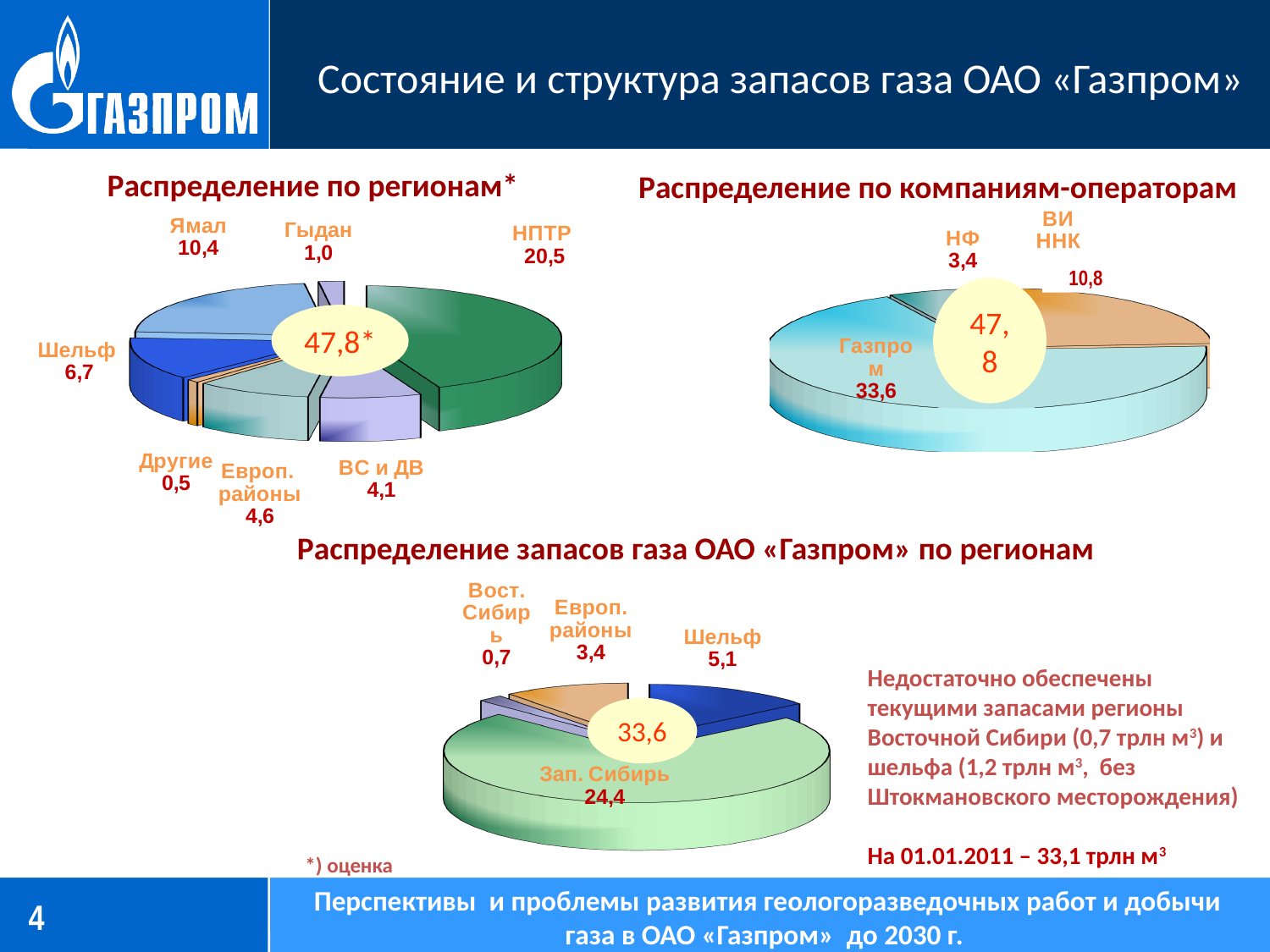
What type of chart is used for 'Распределение запасов газа ОАО «Газпром» по регионам'? Pie chart In the chart 'Распределение запасов газа ОАО «Газпром» по регионам', what is the difference between Шельф and Европ. районы? 1,7 In the chart 'Распределение по регионам*', which region has the largest share? НПТР In the chart 'Распределение запасов газа ОАО «Газпром» по регионам', what is the value for Зап. Сибирь? 24,4 In the chart 'Распределение по регионам*', which category has the smallest value? Другие In the chart 'Распределение по регионам*', how many categories are shown? 7 In the chart 'Распределение по регионам*', what is the difference between the values for Ямал and Шельф? 3,7 In the chart 'Распределение по компаниям-операторам', what total is shown in the centre of the pie? 47,8 In the chart 'Распределение по компаниям-операторам', what is the value for Газпром? 33,6 In the chart 'Распределение по компаниям-операторам', which is larger, ВИ ННК or НФ? ВИ ННК In the chart 'Распределение по регионам*', what is the value for НПТР? 20,5 In the chart 'Распределение запасов газа ОАО «Газпром» по регионам', which region has the smallest value? Вост. Сибирь